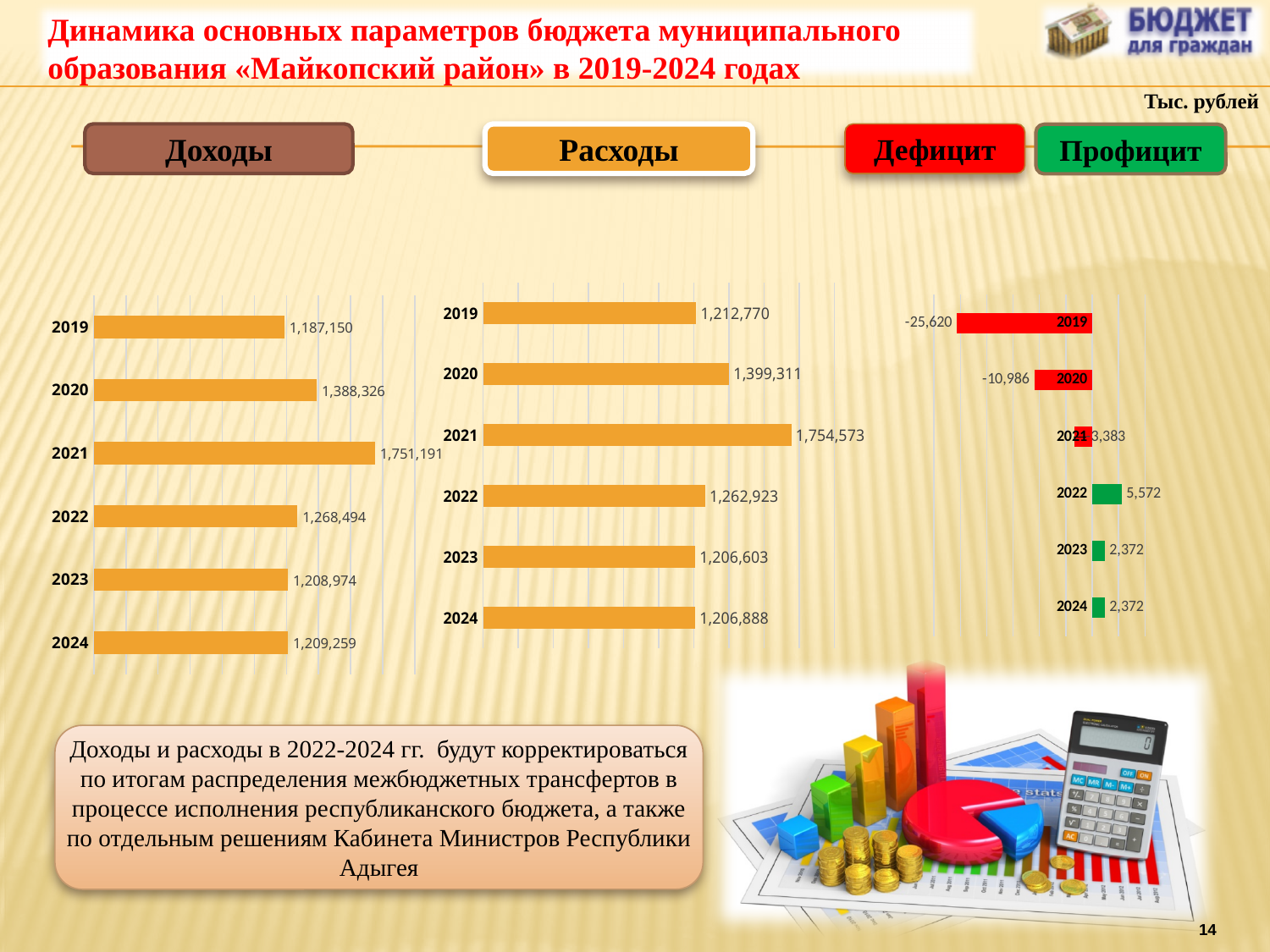
In the Доходы chart, which is larger: the value for 2020 or the value for 2022? 2020 In the Расходы chart, what is the difference between the values for 2021 and 2020? 355,262 In the Доходы chart, which year has the highest value? 2021 In the Расходы chart, what is the value for 2020? 1,399,311 What type of chart is the Доходы chart? Bar chart In the Дефицит/Профицит chart, what colour are the bars for the years with a deficit (negative values)? Red In the Расходы chart, which year has the lowest value? 2023 In the Дефицит/Профицит chart, what is the value for 2022? 5,572 In the Дефицит/Профицит chart, what is the value for 2019? -25,620 How many years are shown in the Расходы chart? 6 In the Доходы chart, what is the value for 2021? 1,751,191 In the Доходы chart, what is the difference between the values for 2021 and 2019? 564,041